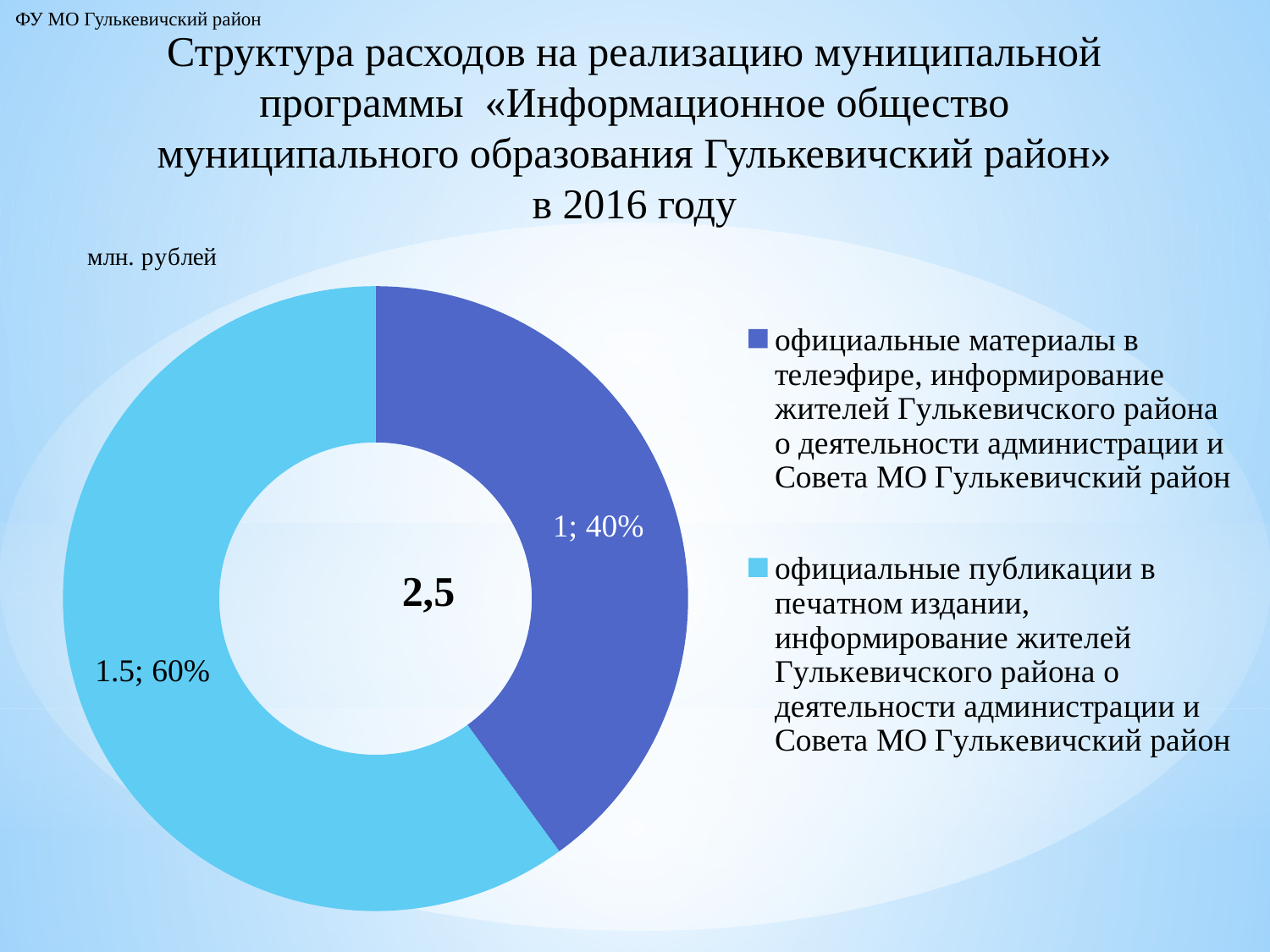
What is the value (in млн. рублей) for «официальные материалы в телеэфире, информирование жителей Гулькевичского района о деятельности администрации и Совета МО Гулькевичский район»? 1 What colour is the slice for «официальные публикации в печатном издании»? Light blue What total value is shown in the centre of the doughnut chart? 2,5 Which category has the largest slice? официальные публикации в печатном издании, информирование жителей Гулькевичского района о деятельности администрации и Совета МО Гулькевичский район What share of the chart does the slice for «официальные публикации в печатном издании» take? 60% How many slices does the chart have? 2 What share of the chart does the slice for «официальные материалы в телеэфире» take? 40% Which category has the smallest slice? официальные материалы в телеэфире, информирование жителей Гулькевичского района о деятельности администрации и Совета МО Гулькевичский район What is the value (in млн. рублей) for «официальные публикации в печатном издании, информирование жителей Гулькевичского района о деятельности администрации и Совета МО Гулькевичский район»? 1.5 How many entries does the legend list? 2 What is the difference in млн. рублей between the slice for «официальные публикации в печатном издании» and the slice for «официальные материалы в телеэфире»? 0.5 What kind of chart is shown on the slide? Doughnut (pie) chart